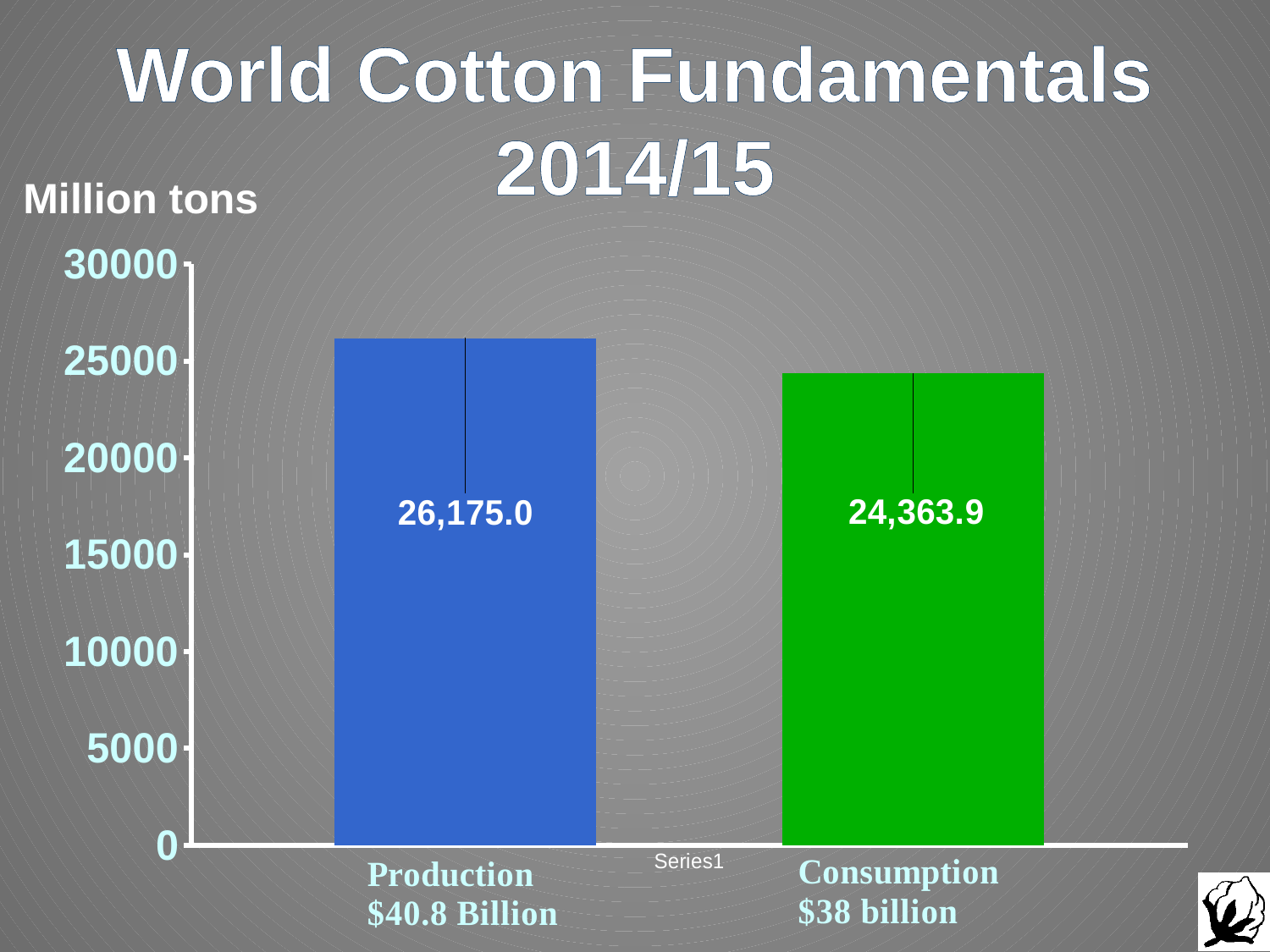
How many bars are plotted on the chart? 2 What is the value of the Production bar? 26,175.0 What unit is given for the vertical axis of the chart? Million tons What is the highest tick value shown on the vertical axis? 30000 What is the difference between the Production and Consumption values? 1,811.1 Which bar is the lowest on the chart? Consumption What dollar value is shown under the Production bar? $40.8 Billion What is the value of the Consumption bar? 24,363.9 What kind of chart is shown on the slide? bar chart Which bar is higher, Production or Consumption? Production Is the value for Production greater or less than 25000? greater Is the value for Consumption greater or less than 25000? less